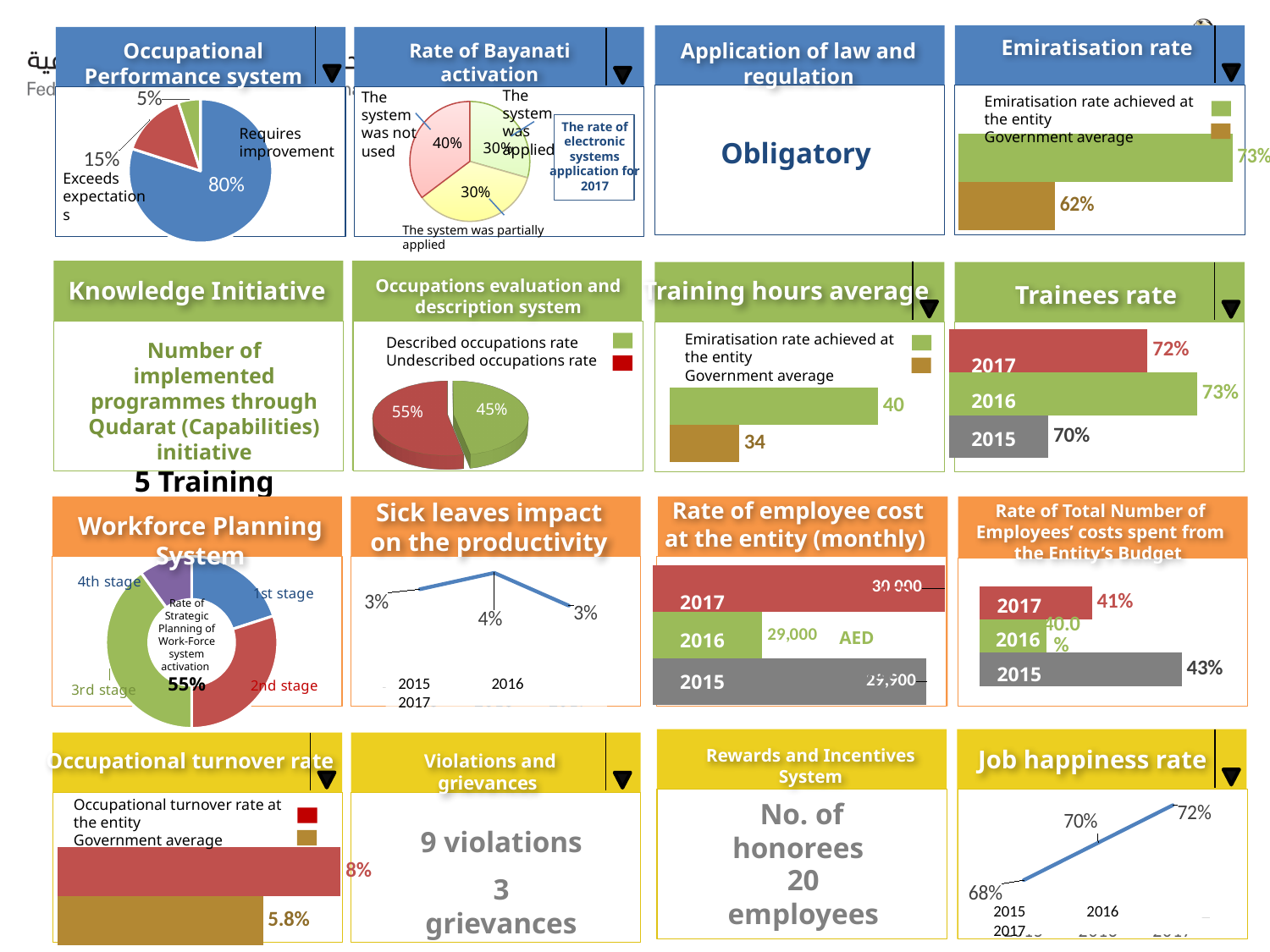
In the Trainees rate chart, what is the trainees rate for 2015? 70% In the Trainees rate chart, which year has the highest trainees rate? 2016 In the Occupational turnover rate chart, which is larger: the rate at the entity or the Government average? Occupational turnover rate at the entity In the Rate of Bayanati activation pie chart, what share is labelled 'The system was not used'? 40% In the Emiratisation rate chart, what is the difference between the rate achieved at the entity and the Government average? 11% In the Rate of Total Number of Employees' costs spent from the Entity's Budget chart, which year has the highest value? 2015 What kind of chart is used in the Occupational Performance system panel? pie chart In the Emiratisation rate chart, what is the Emiratisation rate achieved at the entity? 73% In the Occupations evaluation and description system pie chart, what is the Undescribed occupations rate? 55% In the Job happiness rate chart, do the values rise or fall from 2015 to 2017? rise In the Sick leaves impact on the productivity chart, what is the value for 2016? 4% In the Training hours average chart, what is the Government average value? 34